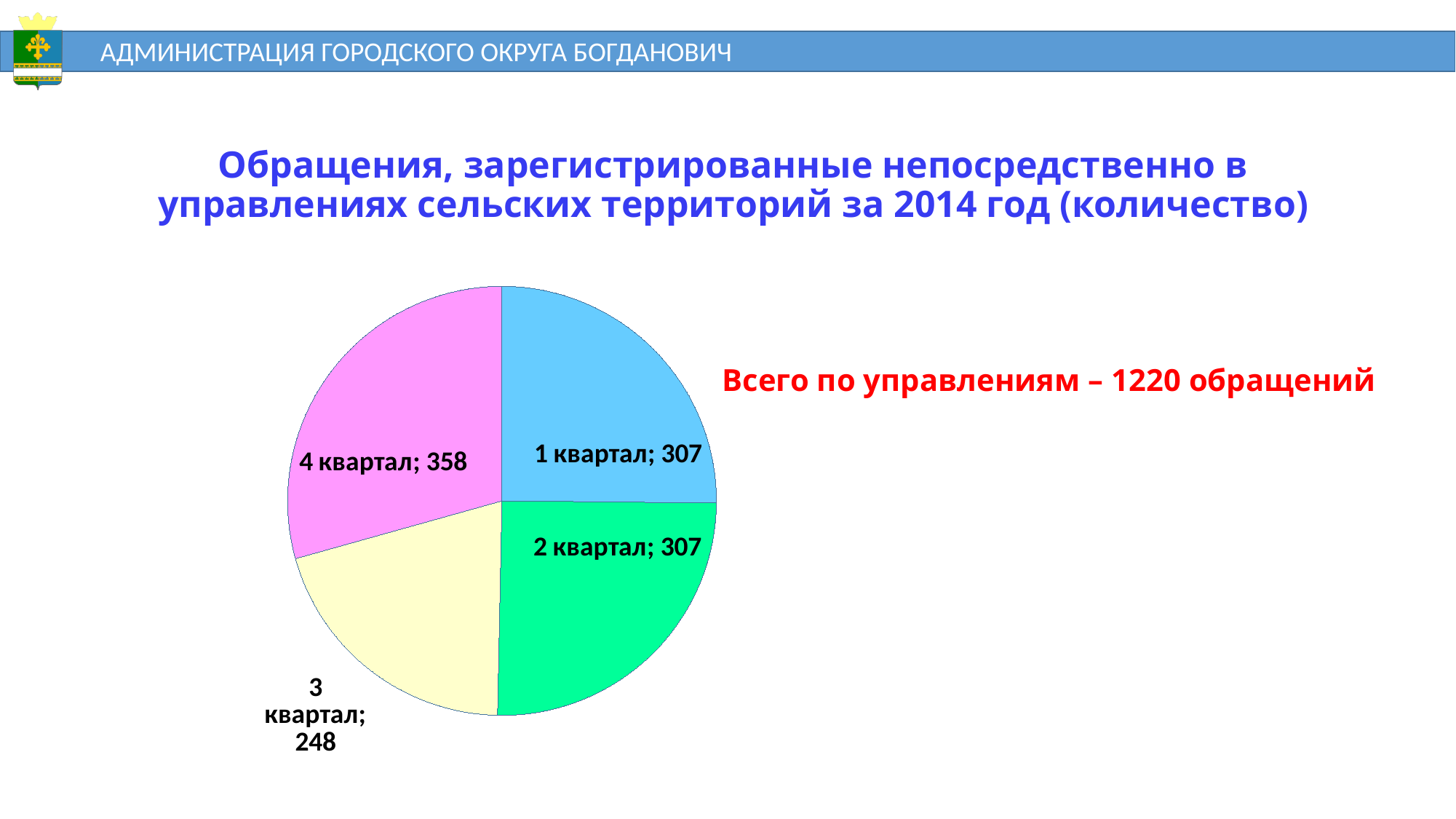
What is the difference between the values for 4 квартал and 1 квартал? 51 What colour is the slice for 2 квартал? green What is the value for 1 квартал in the pie chart? 307 Which is larger, the value for 2 квартал or the value for 3 квартал? 2 квартал What is the value for 4 квартал in the pie chart? 358 Which quarter has the highest number of appeals in the pie chart? 4 квартал What is the difference between the values for 4 квартал and 3 квартал? 110 What is the total number of appeals across all quarters, as stated on the slide? 1220 What kind of chart is shown on the slide? pie chart What is the value for 3 квартал in the pie chart? 248 How many slices does the pie chart have? 4 Which quarter has the lowest number of appeals in the pie chart? 3 квартал